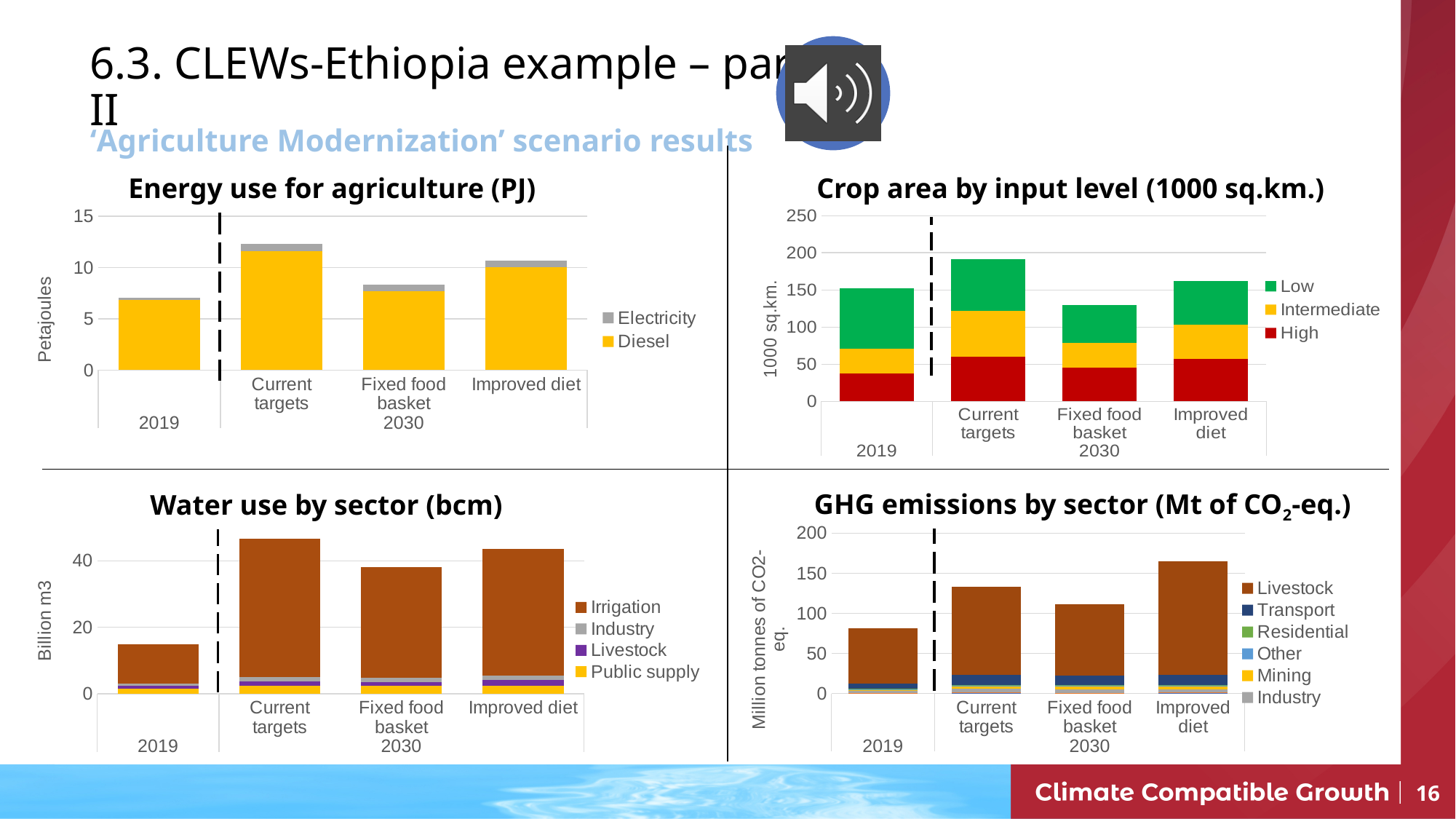
In the 'Energy use for agriculture (PJ)' chart, which is larger, the total for Fixed food basket or for Improved diet? Improved diet In the 'Crop area by input level (1000 sq.km.)' chart, is the total for Fixed food basket greater or less than 150? less In the 'Water use by sector (bcm)' chart, is the total for Current targets greater or less than 40? greater In the 'GHG emissions by sector' chart, which scenario has the highest total emissions? Improved diet In the 'Energy use for agriculture (PJ)' chart, how many series does the legend list? 2 In the 'Water use by sector (bcm)' chart, which scenario has the lowest total water use? 2019 In the 'Energy use for agriculture (PJ)' chart, which scenario has the highest total energy use? Current targets In the 'GHG emissions by sector' chart, how many sectors does the legend list? 6 What kind of chart is the 'Water use by sector (bcm)' chart? Stacked bar chart In the 'Crop area by input level (1000 sq.km.)' chart, how many input levels does the legend list? 3 In the 'Crop area by input level (1000 sq.km.)' chart, which scenario has the largest total crop area? Current targets In the 'Energy use for agriculture (PJ)' chart, is the total for 2019 greater or less than 10? less